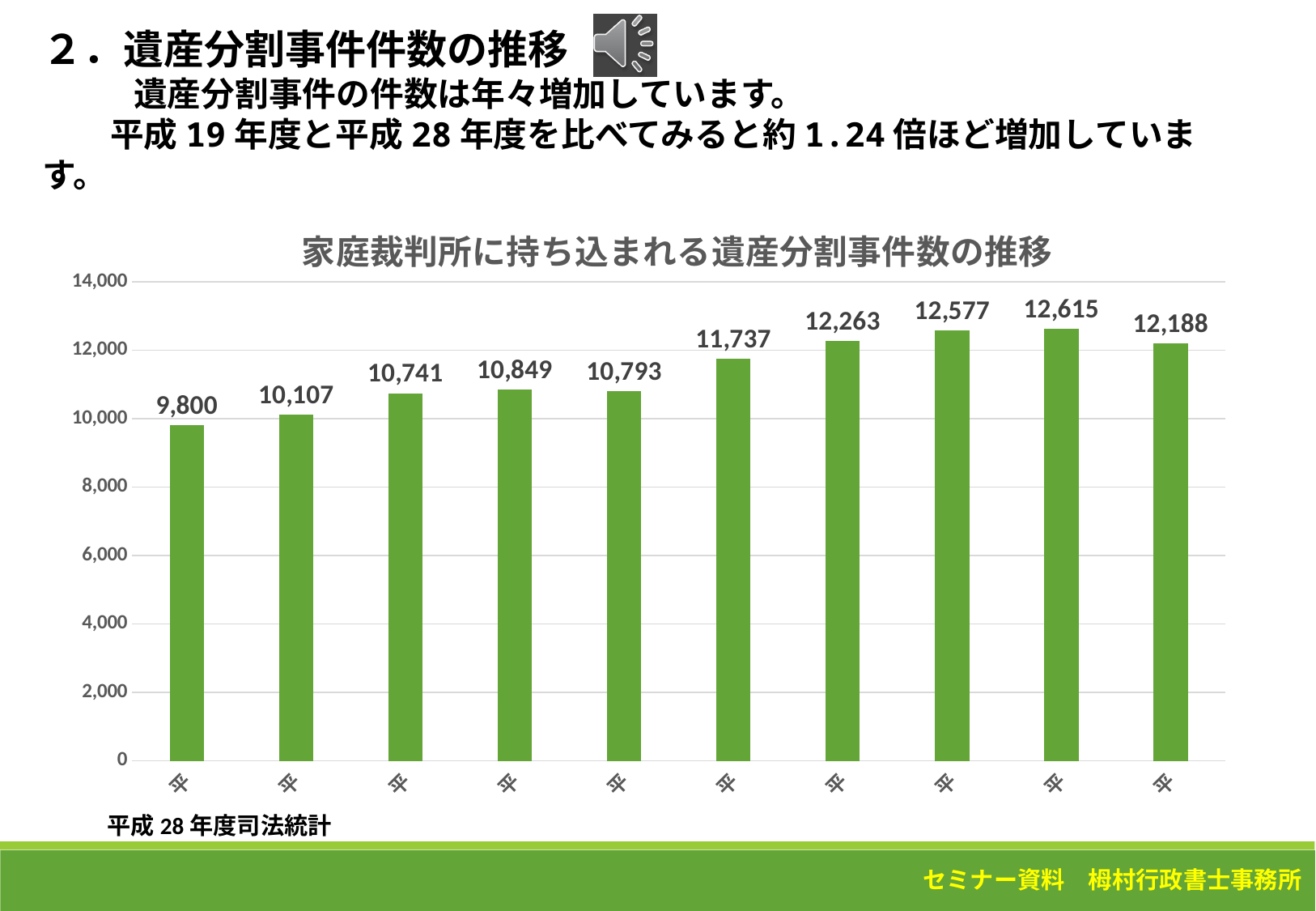
What is the title of the chart? 家庭裁判所に持ち込まれる遺産分割事件数の推移 What kind of chart is shown on the slide? bar chart How many bars are plotted in the chart? 10 What is the value of the sixth bar from the left? 11,737 What is the value of the last (rightmost) bar? 12,188 What is the difference between the rightmost bar and the leftmost bar? 2,388 Is the value of the sixth bar from the left greater or less than 12,000? less What is the lowest value labelled on any bar in the chart? 9,800 Do the values generally rise or fall from left to right across the chart? rise Which is larger, the fourth bar from the left or the fifth bar from the left? the fourth bar (10,849) What is the value of the first (leftmost) bar? 9,800 What is the highest value labelled on any bar in the chart? 12,615